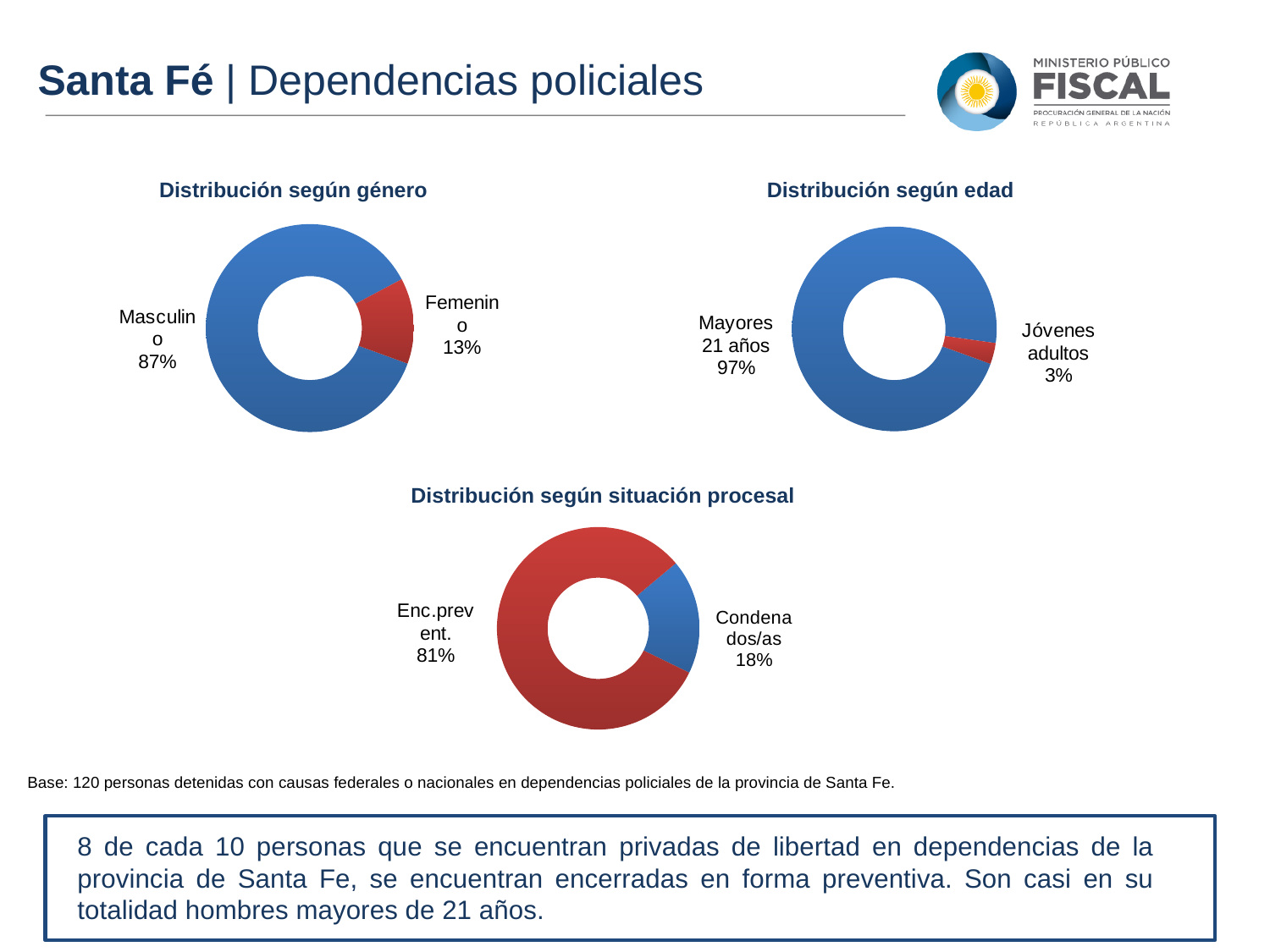
How many categories does the 'Distribución según situación procesal' chart show? 2 In the 'Distribución según situación procesal' chart, what percentage is labelled for Enc.prevent.? 81% In the 'Distribución según género' chart, what percentage is labelled for Femenino? 13% In the 'Distribución según situación procesal' chart, what percentage is labelled for Condenados/as? 18% What kind of chart is 'Distribución según edad'? Doughnut (pie) chart In the 'Distribución según edad' chart, what percentage is labelled for Mayores 21 años? 97% In the 'Distribución según género' chart, which category has the largest share? Masculino In the 'Distribución según género' chart, what percentage is labelled for Masculino? 87% In the 'Distribución según edad' chart, what percentage is labelled for Jóvenes adultos? 3% In the 'Distribución según situación procesal' chart, what is the difference in percentage points between Enc.prevent. and Condenados/as? 63 In the 'Distribución según edad' chart, which category has the smallest share? Jóvenes adultos In the 'Distribución según género' chart, which is larger, Masculino or Femenino? Masculino